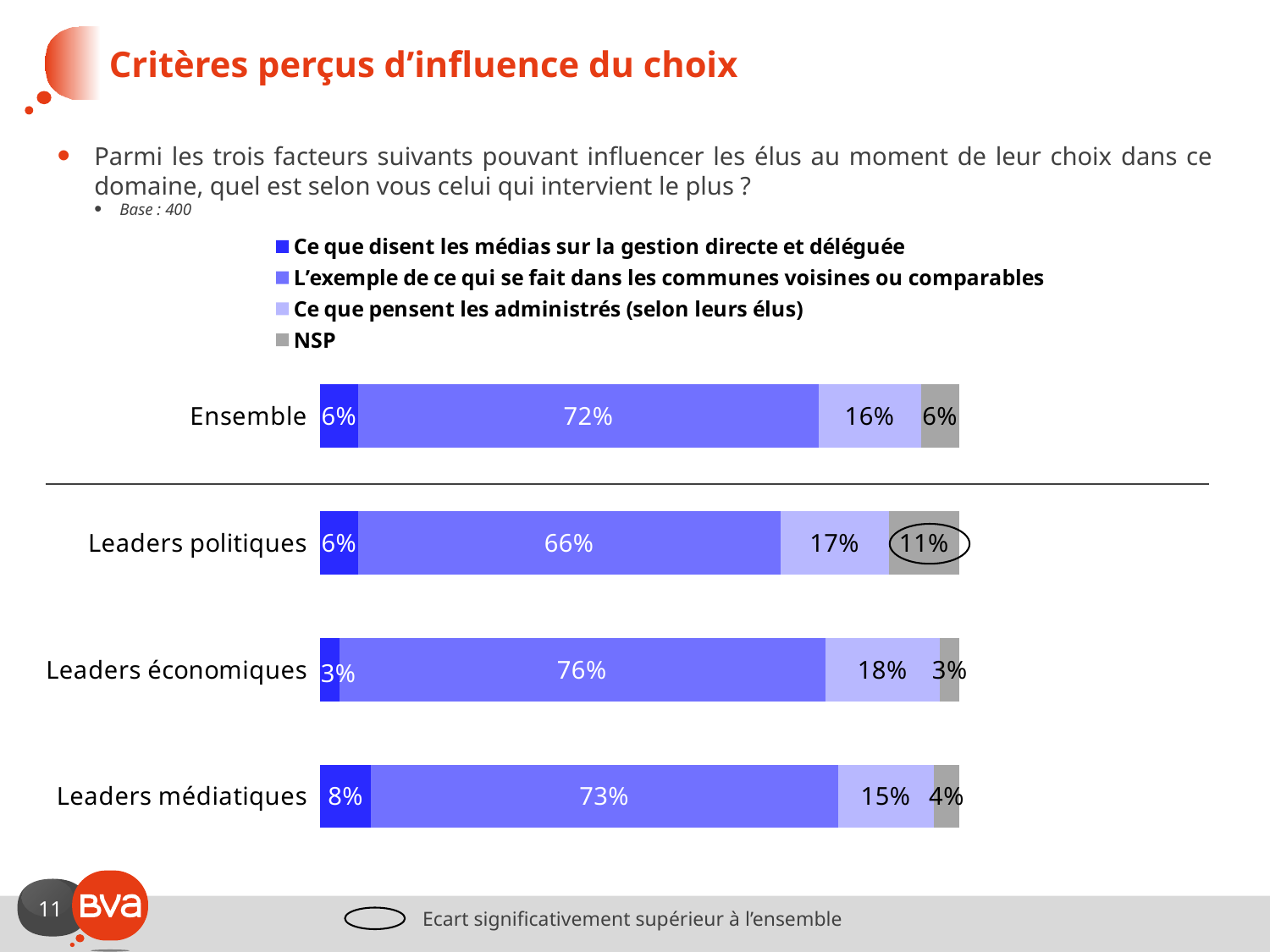
What type of chart is shown on the slide? Stacked bar chart What is the value for "Ce que disent les médias sur la gestion directe et déléguée" among Leaders médiatiques? 8% What is the NSP value for Leaders politiques? 11% Which category has the lowest NSP value? Leaders économiques How many series does the legend list? 4 What is the difference between the "communes voisines" value for Leaders économiques and for Leaders politiques? 10 percentage points What percentage of Leaders économiques chose "Ce que pensent les administrés (selon leurs élus)"? 18% What percentage of Leaders politiques chose "L'exemple de ce qui se fait dans les communes voisines ou comparables"? 66% How many categories (bars) are shown in the chart? 4 Which category has the highest value for "L'exemple de ce qui se fait dans les communes voisines ou comparables"? Leaders économiques What is the base (number of respondents) indicated on the slide? 400 Is the NSP value higher for Leaders politiques or for Leaders médiatiques? Leaders politiques